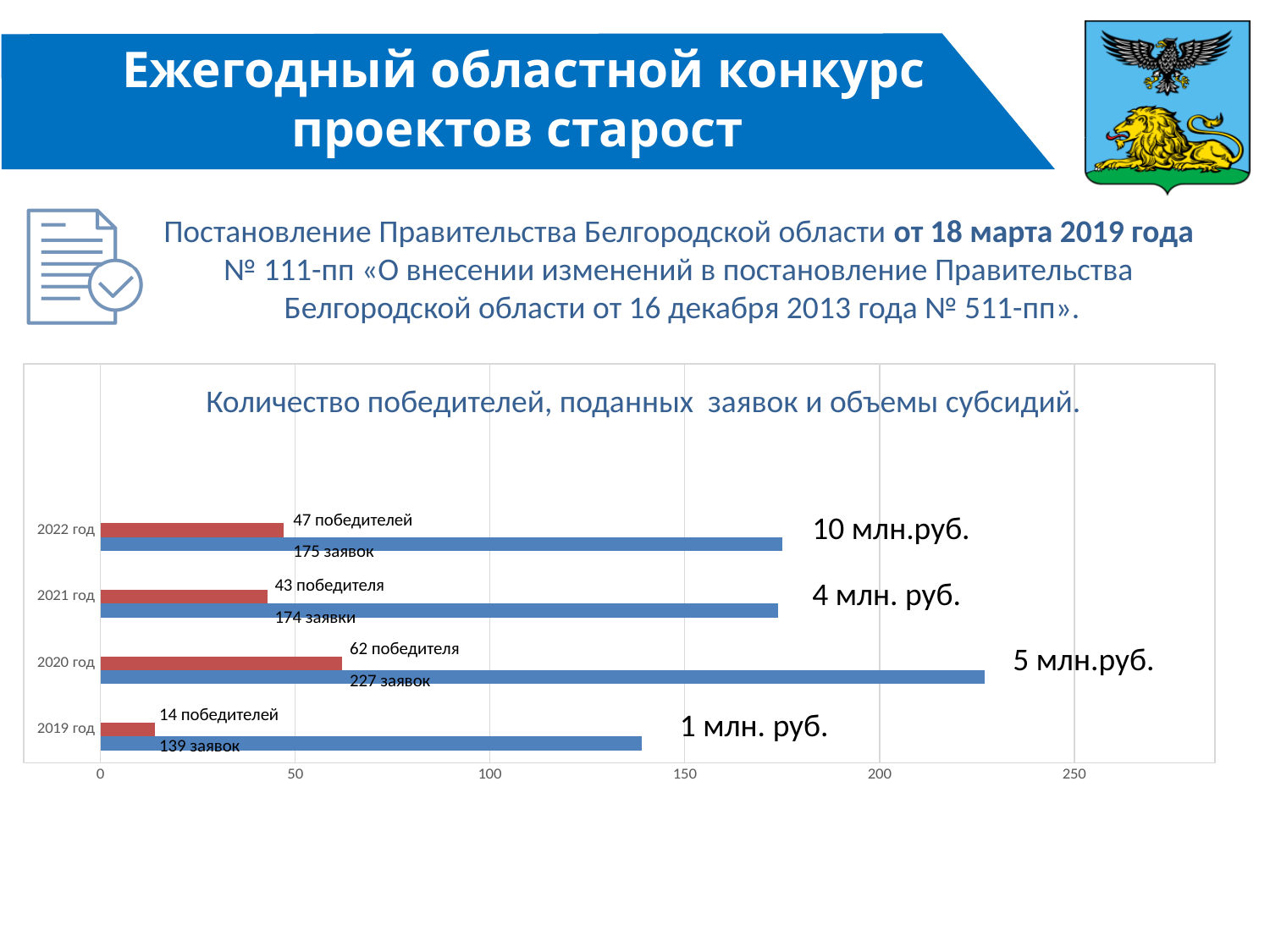
What is the difference between the number of applications in 2022 год and 2021 год? 1 Is the number of applications for 2019 год greater or less than 150? less Which year had the fewest winners? 2019 год What type of chart is shown on the slide? bar chart What is the title of the chart? Количество победителей, поданных заявок и объемы субсидий. How many more winners were there in 2020 год than in 2019 год? 48 Which year had more winners, 2022 год or 2021 год? 2022 год How many applications (заявок) were submitted in 2020 год? 227 заявок How many winners (победителей) were there in 2019 год? 14 победителей Which year had the highest number of applications? 2020 год What subsidy amount is shown for 2022 год? 10 млн.руб. How many years are shown on the chart? 4